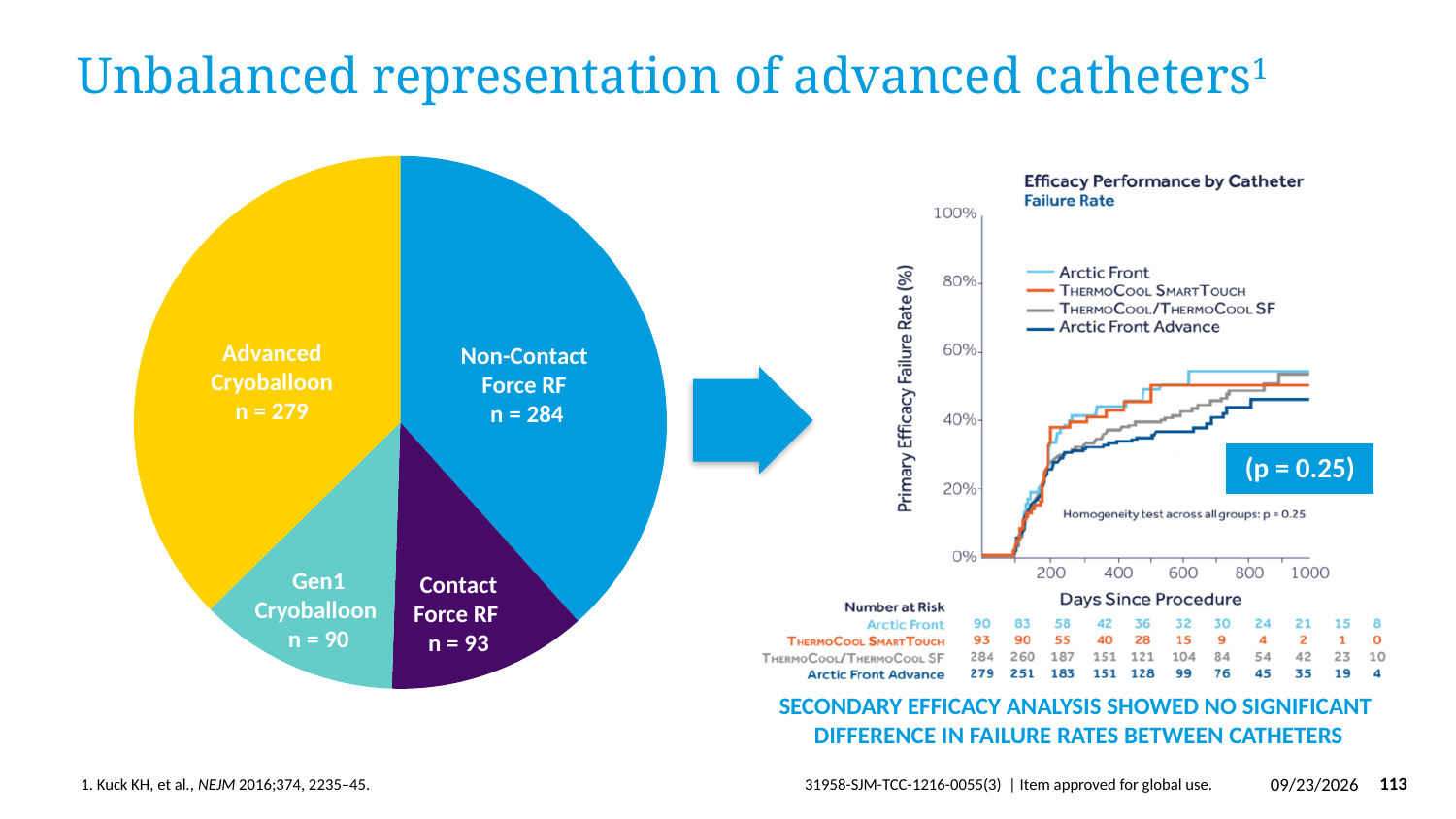
In the pie chart, which category has the smallest n? Gen1 Cryoballoon In the pie chart, what is the n value for Gen1 Cryoballoon? n = 90 In the 'Efficacy Performance by Catheter Failure Rate' chart, how many series does the legend list? 4 In the 'Efficacy Performance by Catheter Failure Rate' chart, do the failure rate curves rise or fall as days since procedure increase? rise How many slices does the pie chart have? 4 In the pie chart, what is the difference in n between Non-Contact Force RF and Contact Force RF? 191 In the pie chart, what is the n value for Non-Contact Force RF? n = 284 In the pie chart, which has a larger n: Advanced Cryoballoon or Contact Force RF? Advanced Cryoballoon In the pie chart, which category has the largest n? Non-Contact Force RF In the 'Efficacy Performance by Catheter Failure Rate' chart, what p-value is shown for the homogeneity test across all groups? p = 0.25 In the 'Efficacy Performance by Catheter Failure Rate' chart, is the Arctic Front Advance failure rate at 1000 days greater or less than 60%? less What kind of chart is on the left side of the slide? pie chart